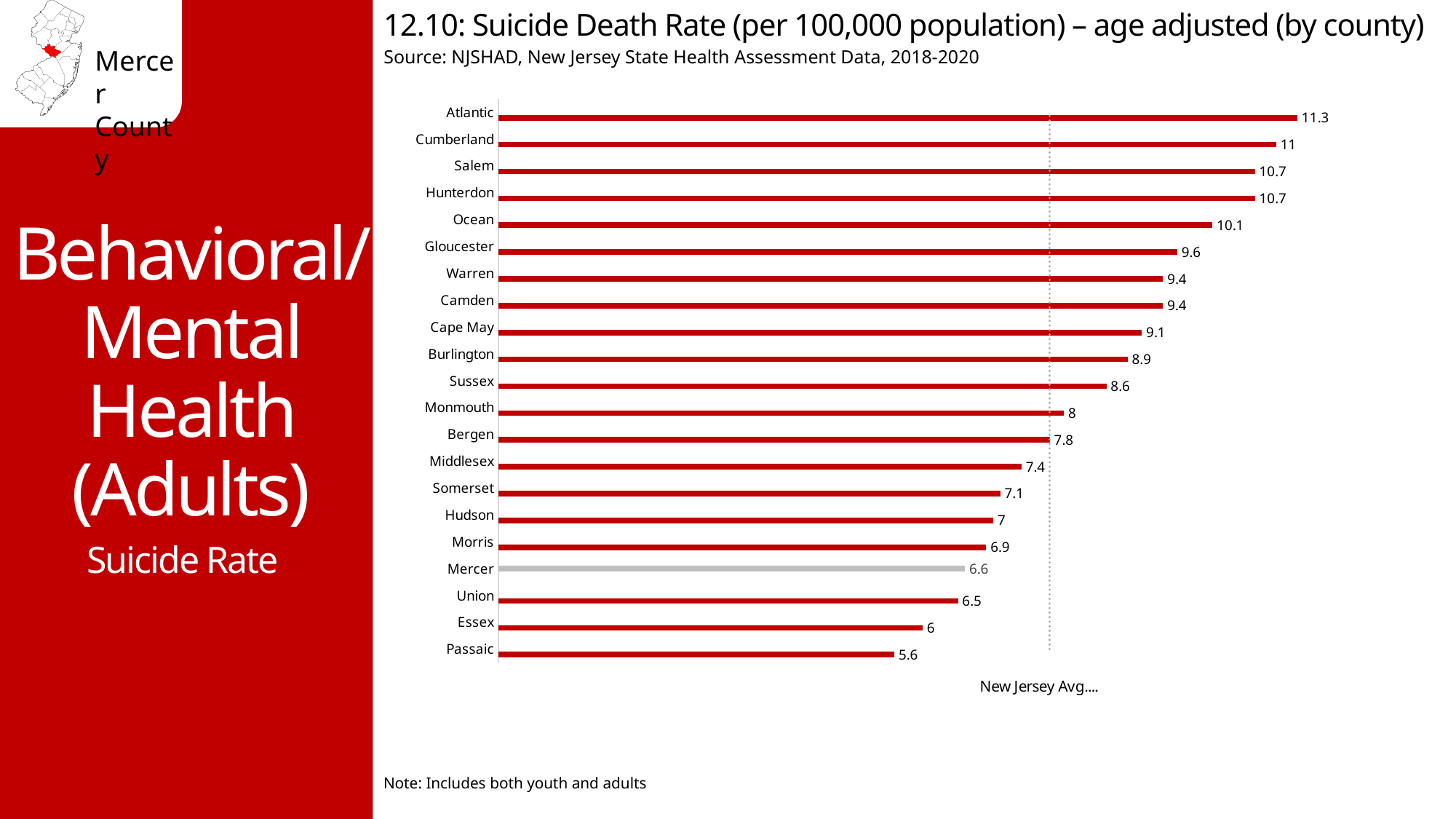
What is the suicide death rate for Mercer County? 6.6 Which county has the lowest suicide death rate? Passaic Which county has the highest suicide death rate? Atlantic Which county's bar is shown in grey instead of red? Mercer How many counties are shown in the chart? 21 What is the difference between the suicide death rates of Ocean and Essex counties? 4.1 What is the suicide death rate for Atlantic County? 11.3 What is the difference between the suicide death rates of Atlantic and Mercer counties? 4.7 Which county has a higher suicide death rate, Gloucester or Bergen? Gloucester What type of chart is used to show the suicide death rates? Bar chart What is the suicide death rate for Passaic County? 5.6 Which county has a higher suicide death rate, Union or Sussex? Sussex